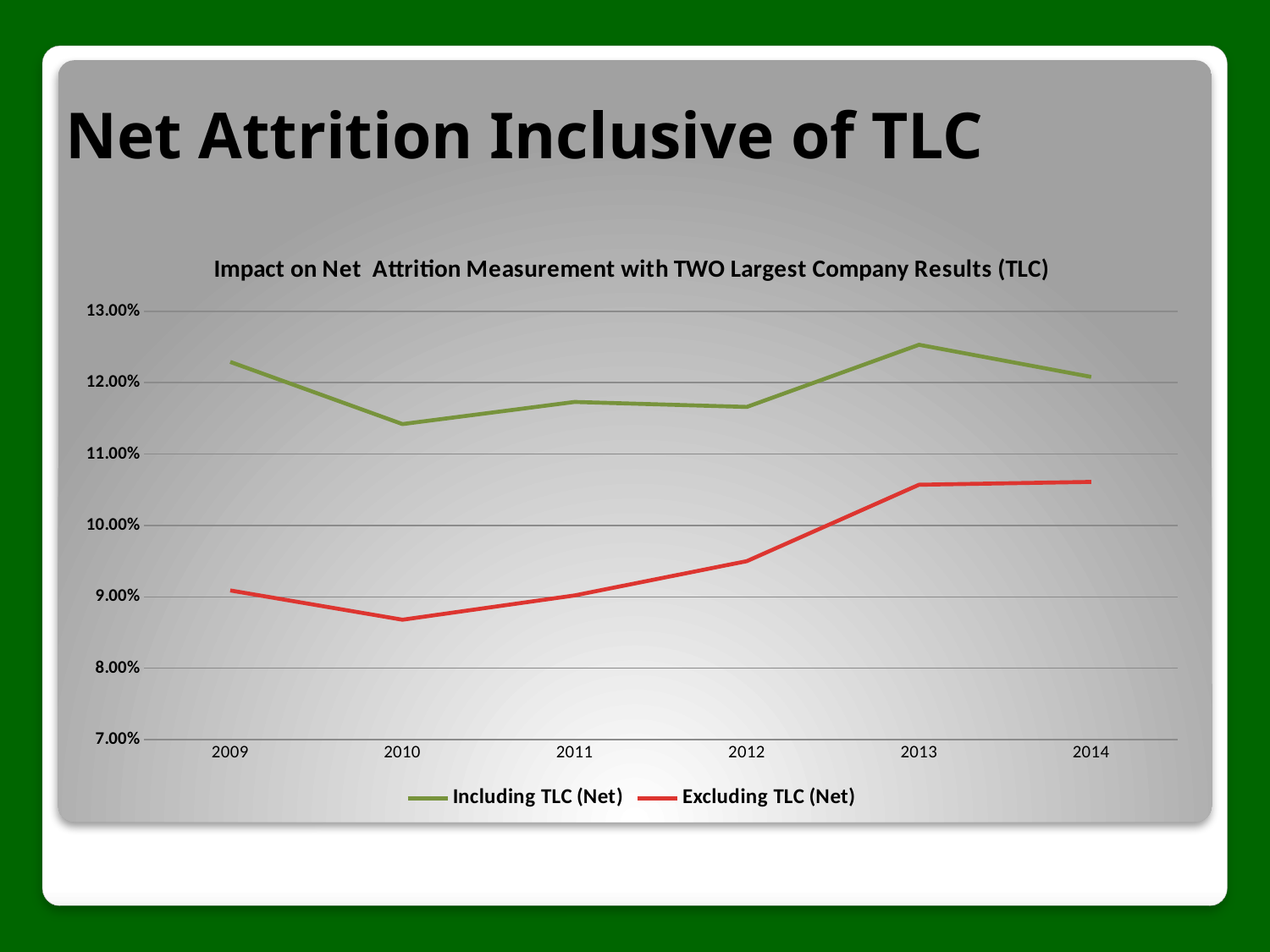
In which year is the Including TLC (Net) series at its lowest? 2010 Is the value for Excluding TLC (Net) in 2013 greater or less than 10.00%? greater In which year is the Excluding TLC (Net) series at its lowest? 2010 What kind of chart is shown on the slide? line chart How many years are shown on the x axis? 6 Is the value for Excluding TLC (Net) in 2010 greater or less than 9.00%? less In 2012, which series has the larger value, Including TLC (Net) or Excluding TLC (Net)? Including TLC (Net) Is the value for Including TLC (Net) in 2013 greater or less than 12.00%? greater In which year is the Including TLC (Net) series at its highest? 2013 How many series does the legend list? 2 What is the title of the chart? Impact on Net Attrition Measurement with TWO Largest Company Results (TLC) Does the Excluding TLC (Net) series rise or fall from 2010 to 2014? rise